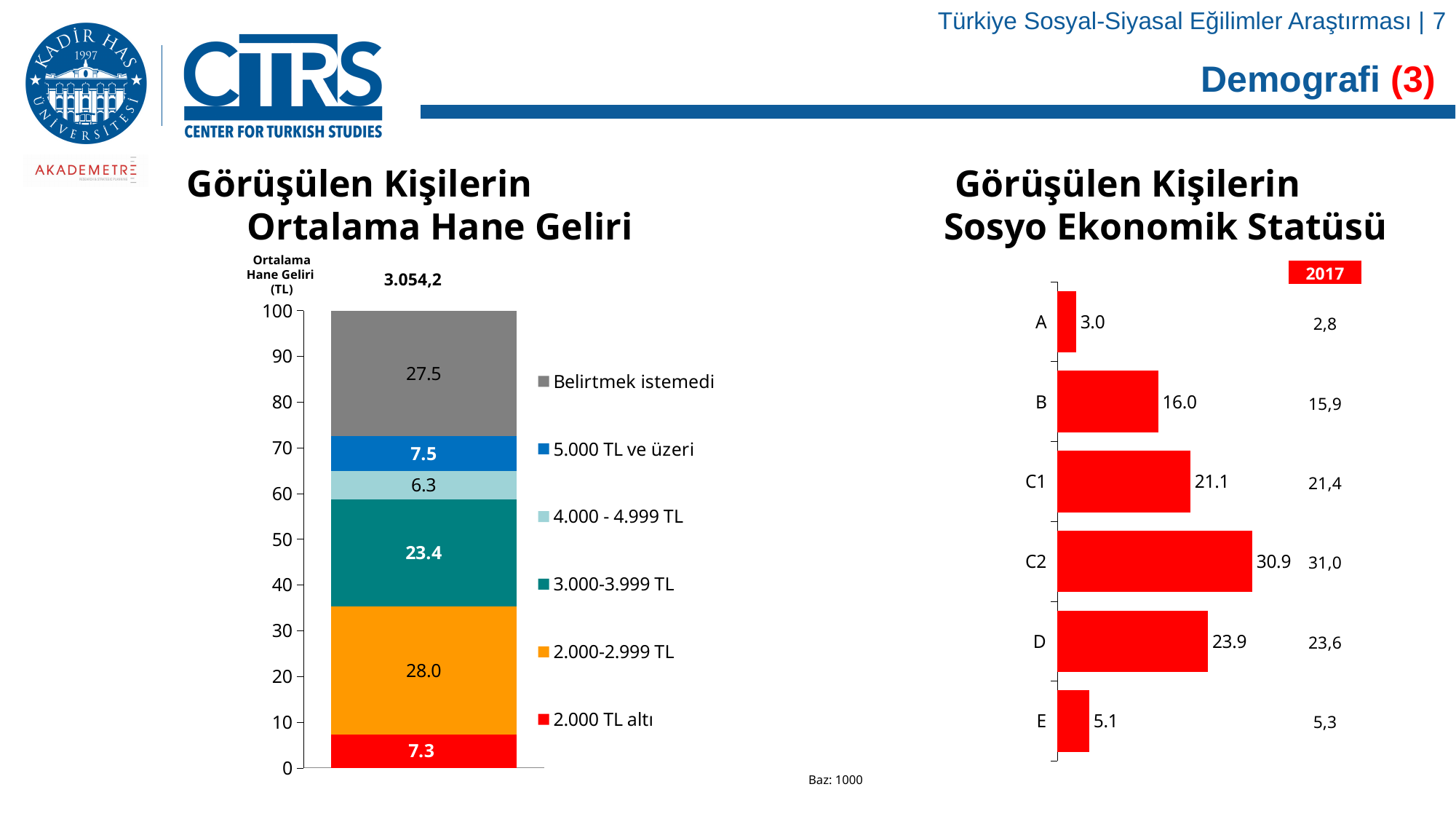
In the 'Görüşülen Kişilerin Sosyo Ekonomik Statüsü' chart, which category has the lowest value? A In the 'Görüşülen Kişilerin Ortalama Hane Geliri' chart, what percentage of respondents fall in the '2.000-2.999 TL' income band? 28.0 In the 'Görüşülen Kişilerin Ortalama Hane Geliri' chart, which is larger: '4.000 - 4.999 TL' or '5.000 TL ve üzeri'? 5.000 TL ve üzeri In the 'Görüşülen Kişilerin Sosyo Ekonomik Statüsü' chart, what is the value for category D? 23.9 In the 'Görüşülen Kişilerin Ortalama Hane Geliri' chart, what average household income (TL) is printed above the bar? 3.054,2 In the 'Görüşülen Kişilerin Ortalama Hane Geliri' chart, what is the value for 'Belirtmek istemedi'? 27.5 In the 'Görüşülen Kişilerin Ortalama Hane Geliri' chart, what is the value for '5.000 TL ve üzeri'? 7.5 In the 'Görüşülen Kişilerin Sosyo Ekonomik Statüsü' chart, what is the difference between the values for C2 and C1? 9.8 In the 'Görüşülen Kişilerin Sosyo Ekonomik Statüsü' chart, how many categories are shown? 6 In the 'Görüşülen Kişilerin Sosyo Ekonomik Statüsü' chart, which category has the highest value? C2 In the 'Görüşülen Kişilerin Ortalama Hane Geliri' chart, how many series does the legend list? 6 In the 'Görüşülen Kişilerin Ortalama Hane Geliri' chart, what is the difference between the '2.000-2.999 TL' and '3.000-3.999 TL' segments? 4.6